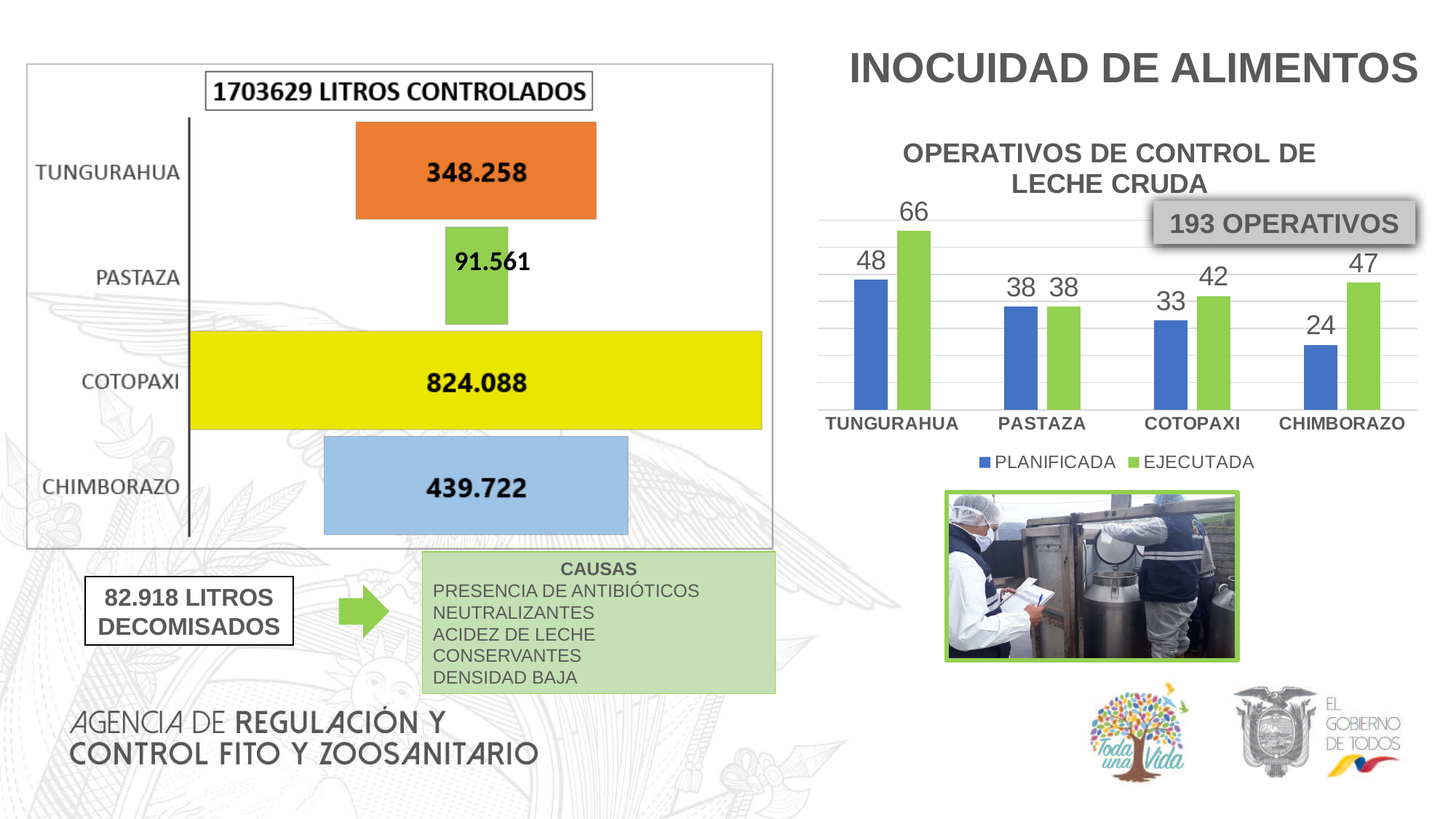
In the '1703629 LITROS CONTROLADOS' chart, which province has the lowest value? PASTAZA In the '1703629 LITROS CONTROLADOS' chart, what colour is the COTOPAXI bar? Yellow In the 'OPERATIVOS DE CONTROL DE LECHE CRUDA' chart, what is the PLANIFICADA value for COTOPAXI? 33 In the '1703629 LITROS CONTROLADOS' chart, what is the difference between CHIMBORAZO and TUNGURAHUA? 91.464 In the '1703629 LITROS CONTROLADOS' chart, what is the value for COTOPAXI? 824.088 In the 'OPERATIVOS DE CONTROL DE LECHE CRUDA' chart, what is the difference between PLANIFICADA and EJECUTADA for CHIMBORAZO? 23 What type of chart is the 'OPERATIVOS DE CONTROL DE LECHE CRUDA' chart? Bar chart How many series does the legend of the 'OPERATIVOS DE CONTROL DE LECHE CRUDA' chart list? 2 In the 'OPERATIVOS DE CONTROL DE LECHE CRUDA' chart, which province has the highest EJECUTADA value? TUNGURAHUA In the '1703629 LITROS CONTROLADOS' chart, how many provinces are shown? 4 In the 'OPERATIVOS DE CONTROL DE LECHE CRUDA' chart, which is larger for TUNGURAHUA, PLANIFICADA or EJECUTADA? EJECUTADA In the 'OPERATIVOS DE CONTROL DE LECHE CRUDA' chart, what is the EJECUTADA value for CHIMBORAZO? 47